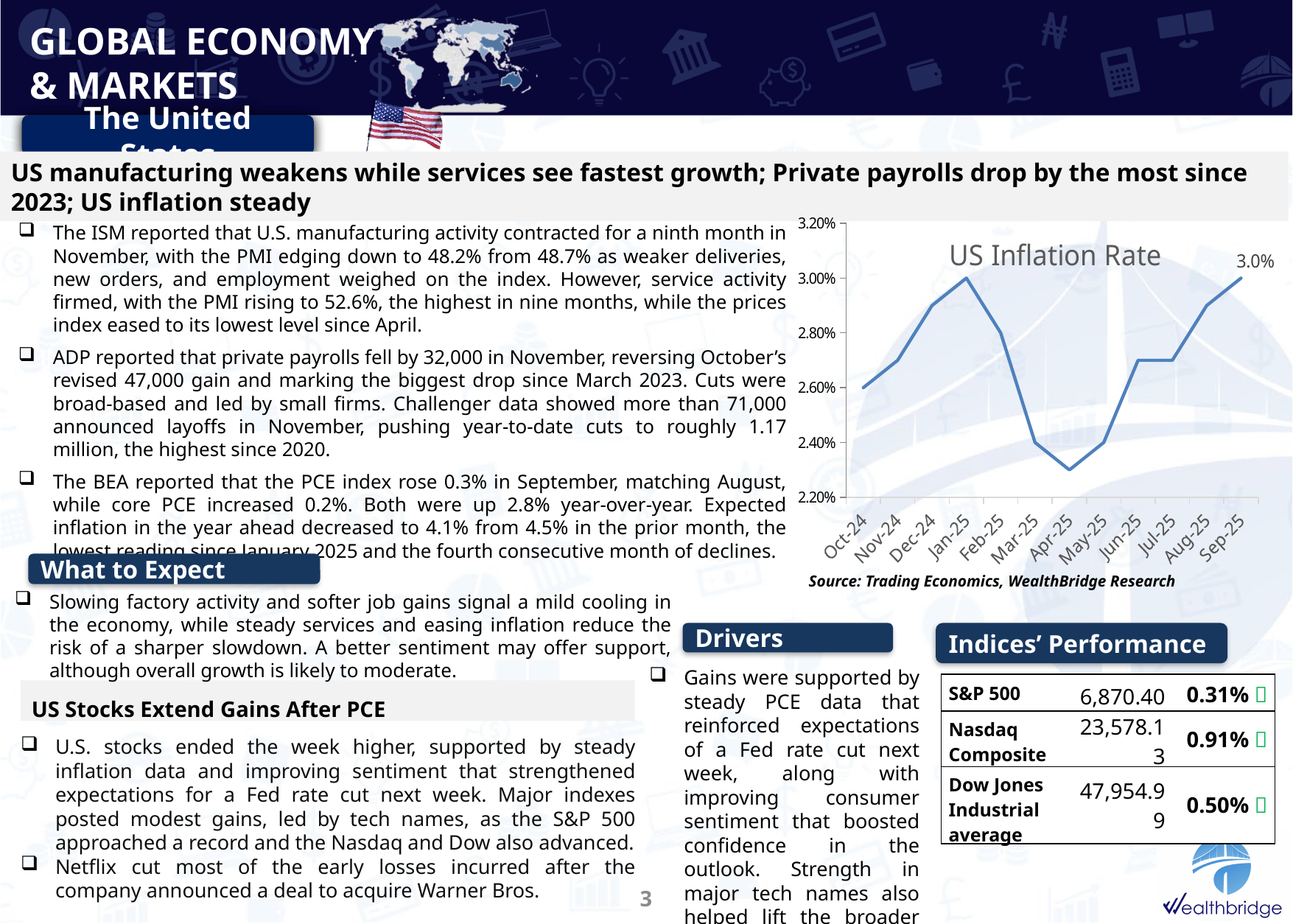
Which month has the higher US inflation rate, Dec-24 or Mar-25? Dec-24 Is the US inflation rate for Jun-25 greater or less than 2.60%? greater Is the US inflation rate for Dec-24 greater or less than 2.80%? greater Does the US inflation rate rise or fall from Apr-25 to Sep-25? rise Is the US inflation rate for Apr-25 greater or less than 2.40%? less Which month shows the lowest US inflation rate on the chart? Apr-25 What is the US inflation rate shown for Sep-25? 3.0% What type of chart is used to show the US Inflation Rate? line chart Does the US inflation rate rise or fall from Jan-25 to Apr-25? fall How many months are plotted on the US Inflation Rate chart? 12 What is the title of the chart on the slide? US Inflation Rate